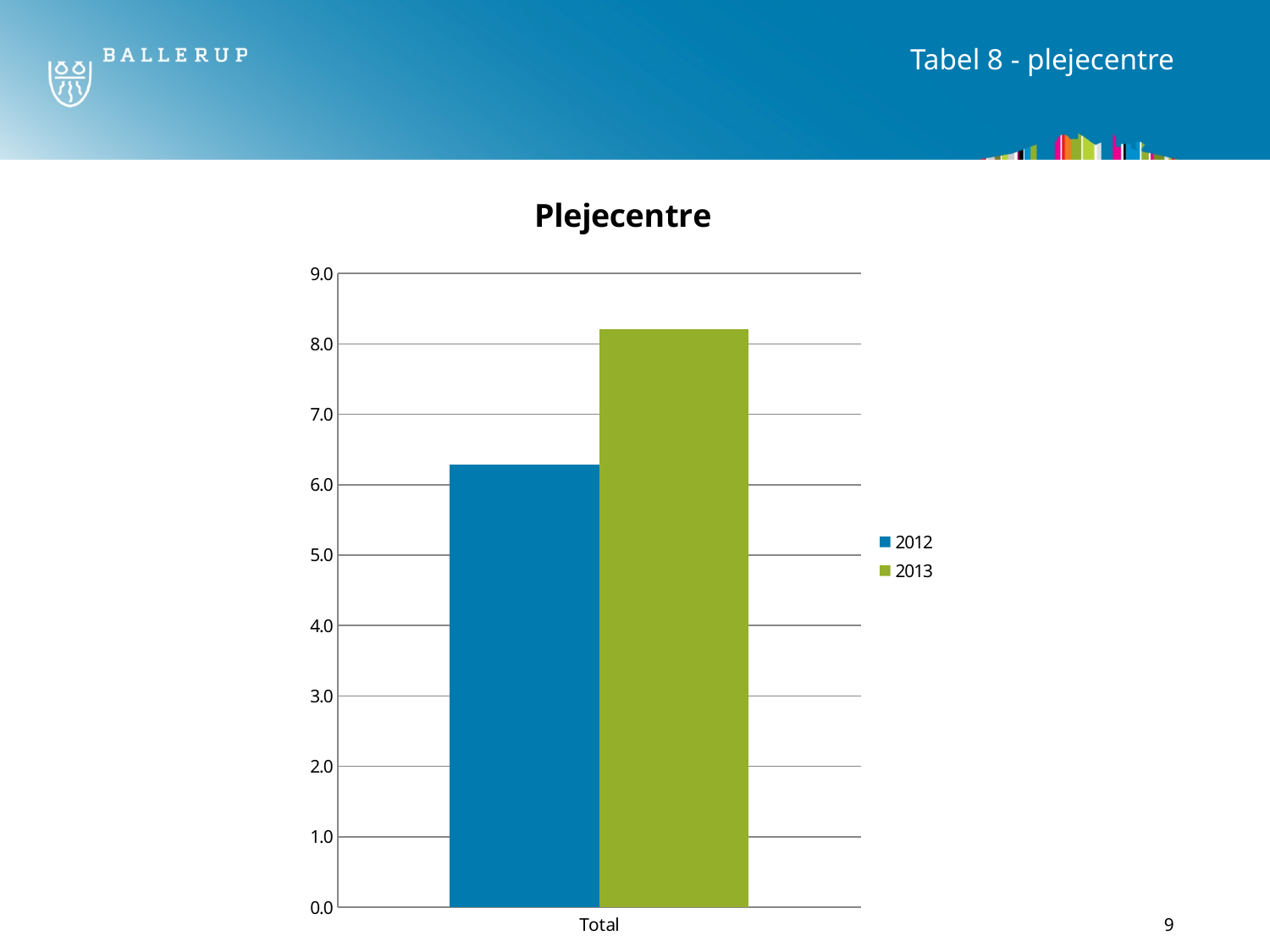
What is the category label on the x axis? Total How many categories are shown on the x axis? 1 Which series has the higher value for Total, 2012 or 2013? 2013 Is the value for 2013 greater or less than 8.0? greater What is the maximum value shown on the y axis? 9.0 Is the value for 2012 greater or less than 6.0? greater What is the title of the chart? Plejecentre Is the value for 2013 greater or less than 9.0? less Which series are listed in the legend? 2012 and 2013 What kind of chart is shown on the slide? bar chart How many series does the legend list? 2